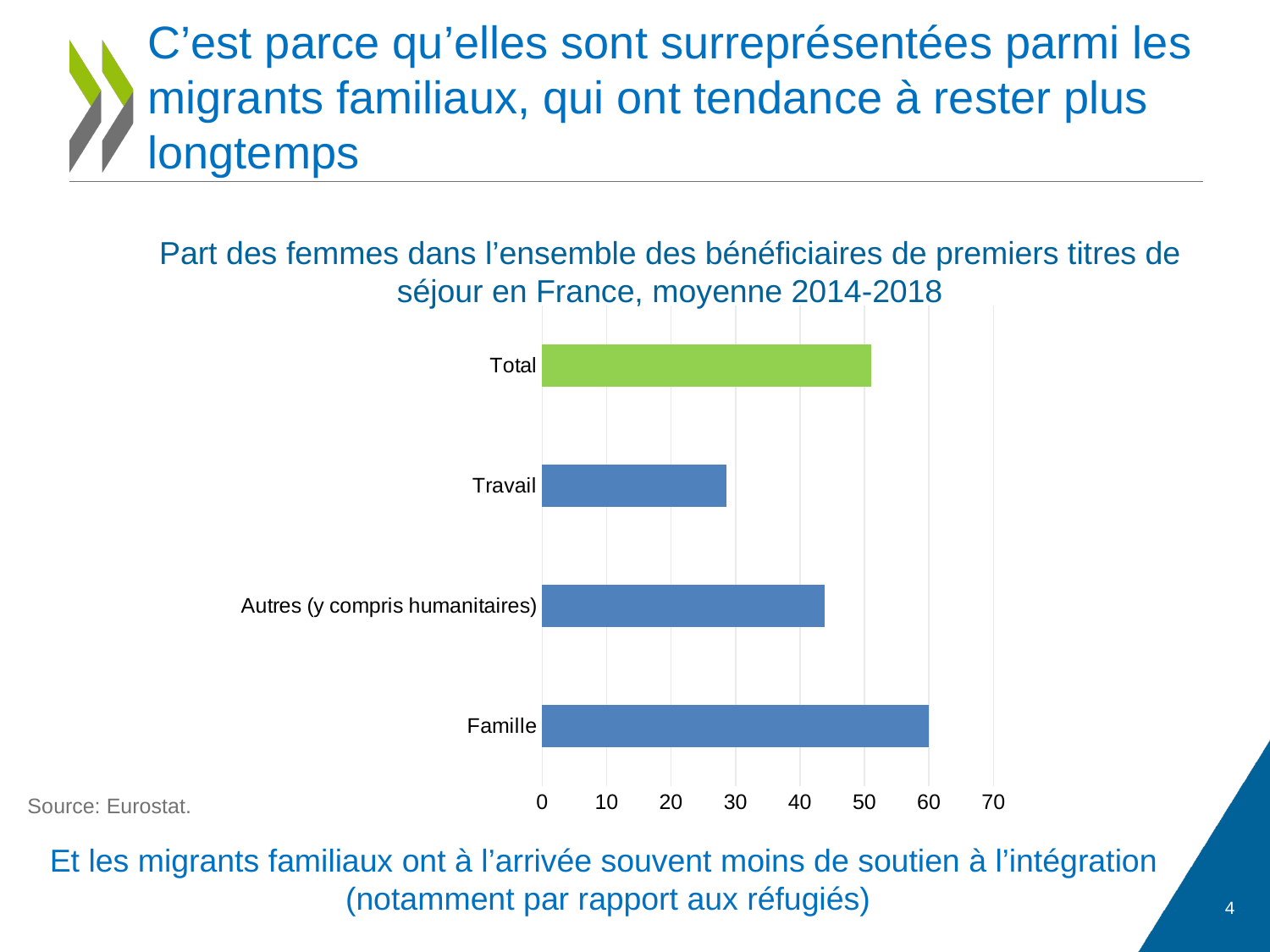
Is the value for Famille greater or less than 50? greater What is the source cited for the chart? Eurostat Which is larger, the value for Famille or the value for Travail? Famille Which category has the lowest share of women? Travail Is the value for Total greater or less than 50? greater Is the value for Travail greater or less than 30? less What kind of chart is shown on the slide? bar chart Which category has the highest share of women? Famille Which bar is coloured green rather than blue? Total Which is larger, the value for Autres (y compris humanitaires) or the value for Total? Total How many categories are plotted in the chart? 4